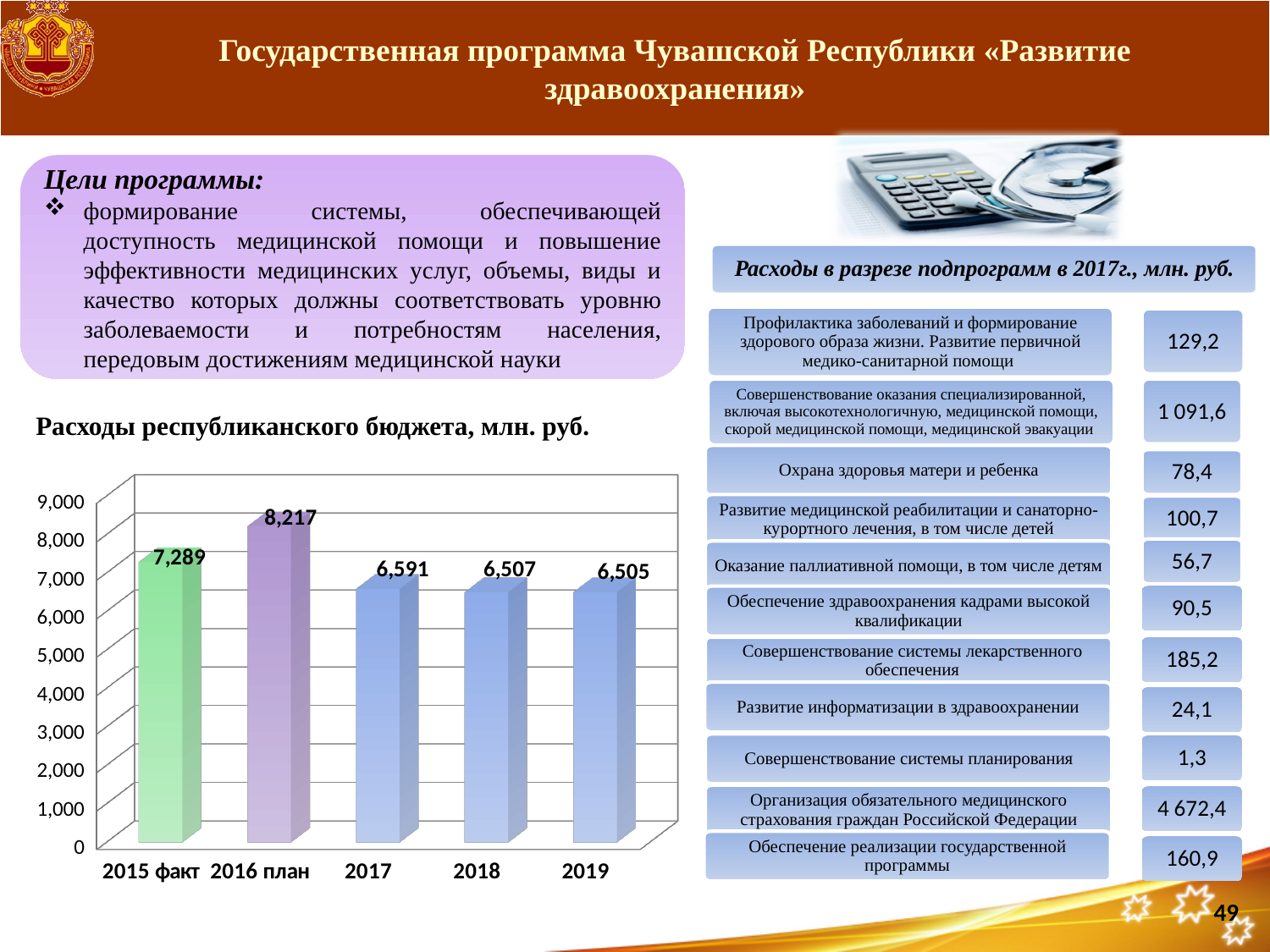
Which is larger, the value for 2015 факт or the value for 2017? 2015 факт What is the value for 2019 in the chart? 6,505 What kind of chart is shown on the slide? bar chart What is the value for 2016 план in the chart? 8,217 How many categories are shown on the x axis of the chart? 5 What is the value for 2017 in the chart? 6,591 Which category has the highest value in the chart? 2016 план What is the value for 2015 факт in the chart "Расходы республиканского бюджета, млн. руб."? 7,289 What is the difference between the values for 2017 and 2018? 84 Which category has the lowest value in the chart? 2019 What is the difference between the values for 2016 план and 2015 факт? 928 What is the title of the chart on the slide? Расходы республиканского бюджета, млн. руб.